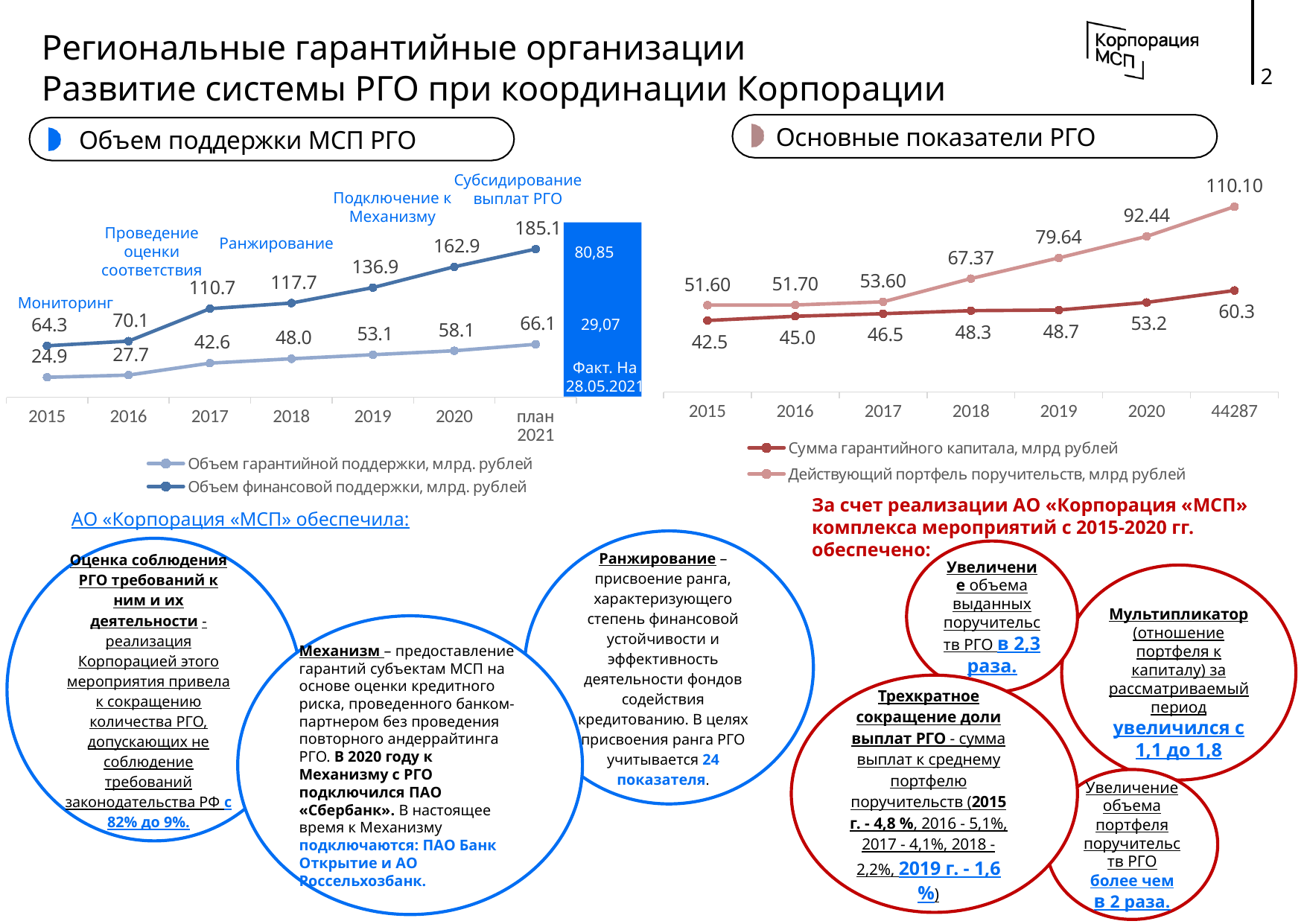
In the chart 'Объем поддержки МСП РГО', what is the value of 'Объем гарантийной поддержки, млрд. рублей' for 2017? 42.6 In the chart 'Объем поддержки МСП РГО', what is the value of 'Объем финансовой поддержки, млрд. рублей' for 2019? 136.9 In the chart 'Основные показатели РГО', how many categories are shown on the x axis? 7 In the chart 'Объем поддержки МСП РГО', does 'Объем гарантийной поддержки' rise or fall from 2015 to план 2021? rise What type of chart is 'Основные показатели РГО'? line chart In the chart 'Объем поддержки МСП РГО', what is the difference between 'Объем финансовой поддержки' and 'Объем гарантийной поддержки' in 2020? 104.8 In the chart 'Основные показатели РГО', what is the value of 'Сумма гарантийного капитала, млрд рублей' for 2019? 48.7 In the chart 'Объем поддержки МСП РГО', how many series does the legend list? 2 In the chart 'Основные показатели РГО', which category has the lowest value for 'Сумма гарантийного капитала, млрд рублей'? 2015 In the chart 'Основные показатели РГО', what is the value of 'Действующий портфель поручительств, млрд рублей' for 2018? 67.37 In the chart 'Объем поддержки МСП РГО', which category has the highest value for 'Объем финансовой поддержки, млрд. рублей'? план 2021 In the chart 'Основные показатели РГО', which is larger in 2020: 'Действующий портфель поручительств' or 'Сумма гарантийного капитала'? Действующий портфель поручительств